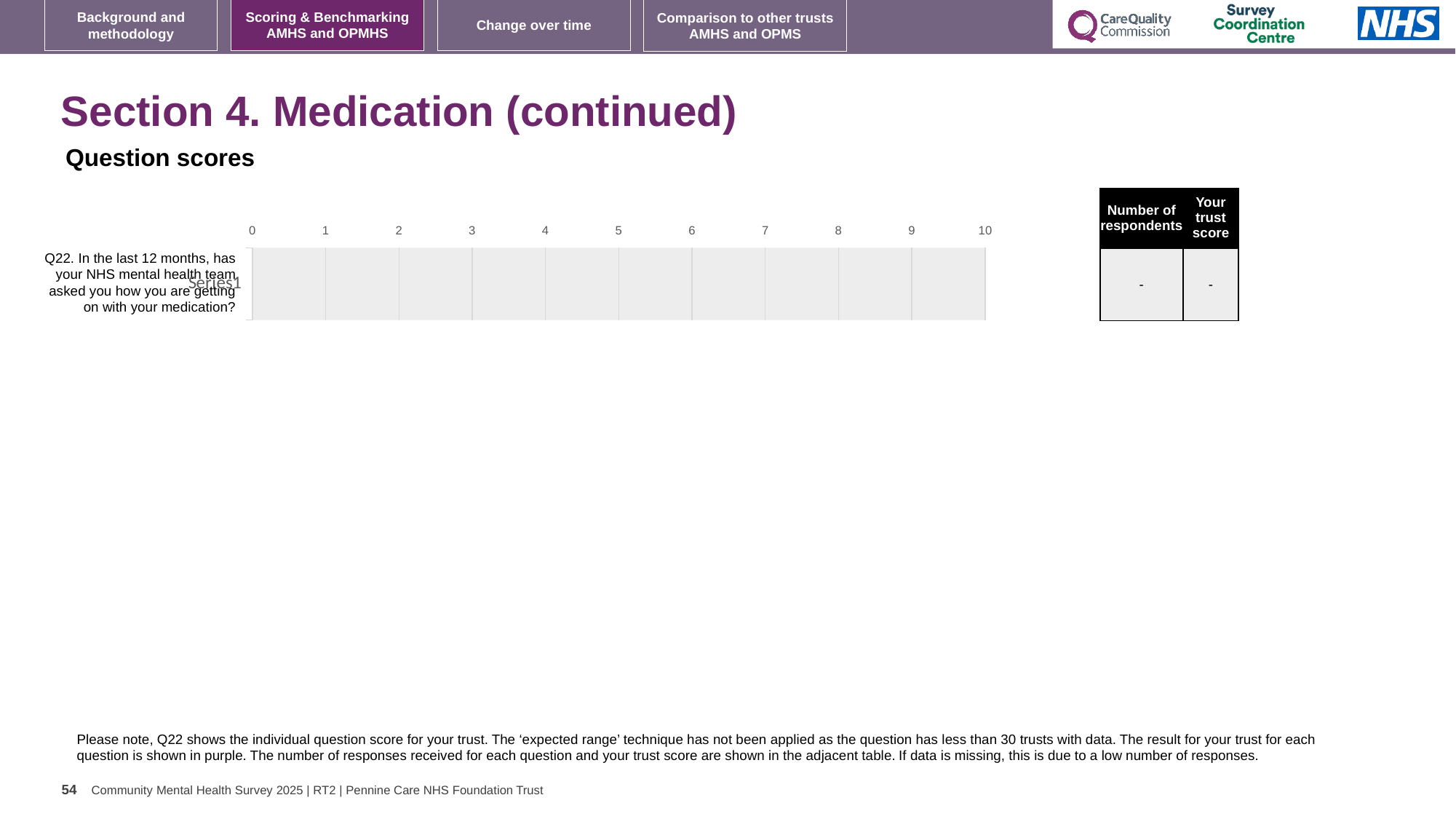
Which question number is shown as the category on the chart? Q22 What is the lowest value shown on the chart's horizontal axis? 0 How many question categories are listed on the chart's vertical axis? 1 What is the 'Number of respondents' value shown in the table next to the chart for Q22? - What is the highest value shown on the chart's horizontal axis? 10 Is any bar plotted on the chart for Q22? No What is the 'Your trust score' value shown in the table next to the chart for Q22? -